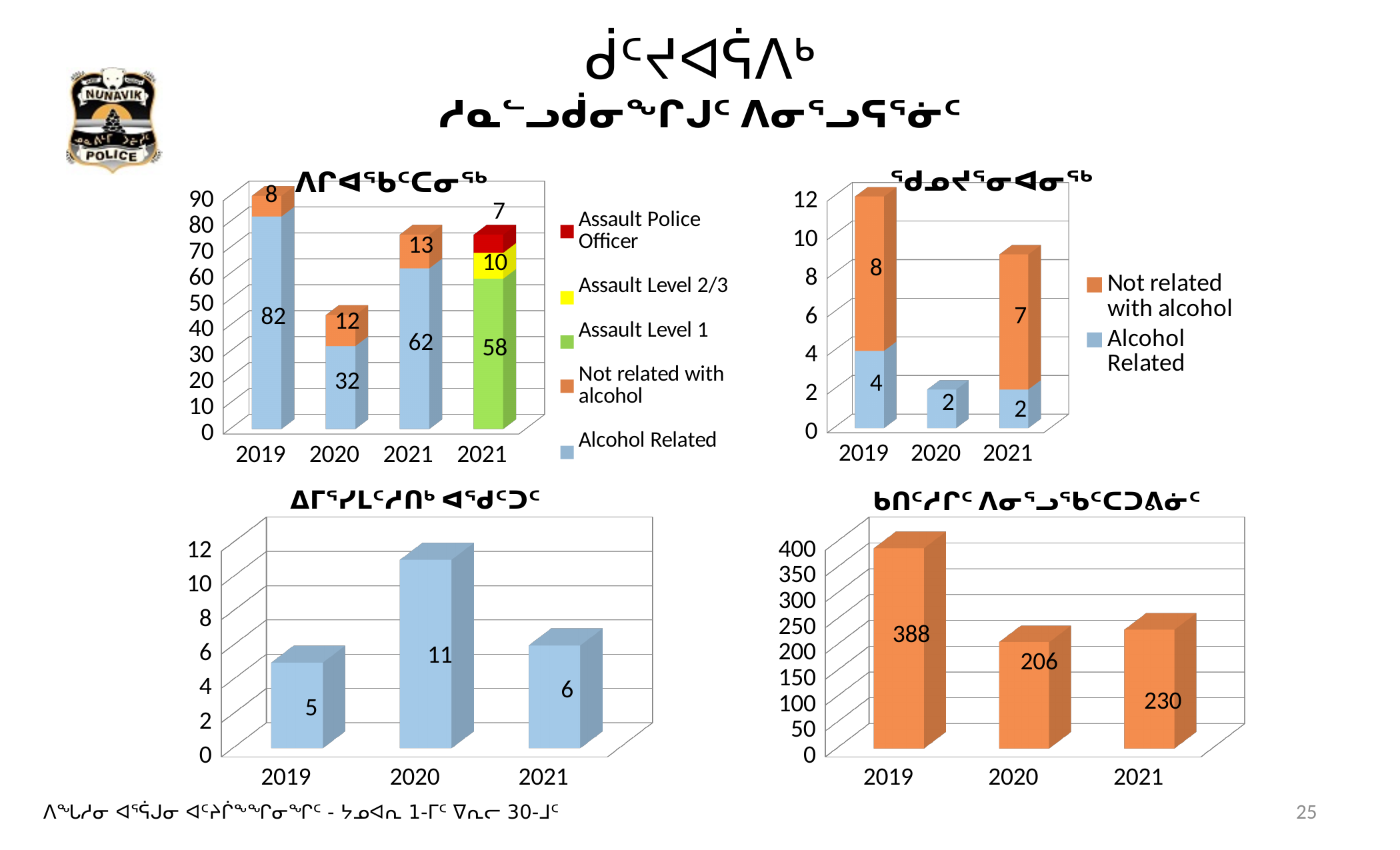
In the bottom-right chart, what is the difference between the values for 2019 and 2021? 158 In the bottom-left chart, what is the value for 2021? 6 In the bottom-left chart, how many years are shown on the x axis? 3 In the bottom-right chart, which year has the lowest value? 2020 In the top-right chart, what is the Not related with alcohol value for 2021? 7 In the top-left chart, how many series does the legend list? 5 In the bottom-right chart, what is the value for 2019? 388 In the top-right chart, what is the total of the stacked bar for 2019? 12 In the top-left chart, what is the total of the stacked bar for 2019? 90 In the bottom-left chart, which year has the highest value? 2020 What kind of chart is the bottom-right chart? bar chart In the top-left chart, what is the Alcohol Related value for 2020? 32